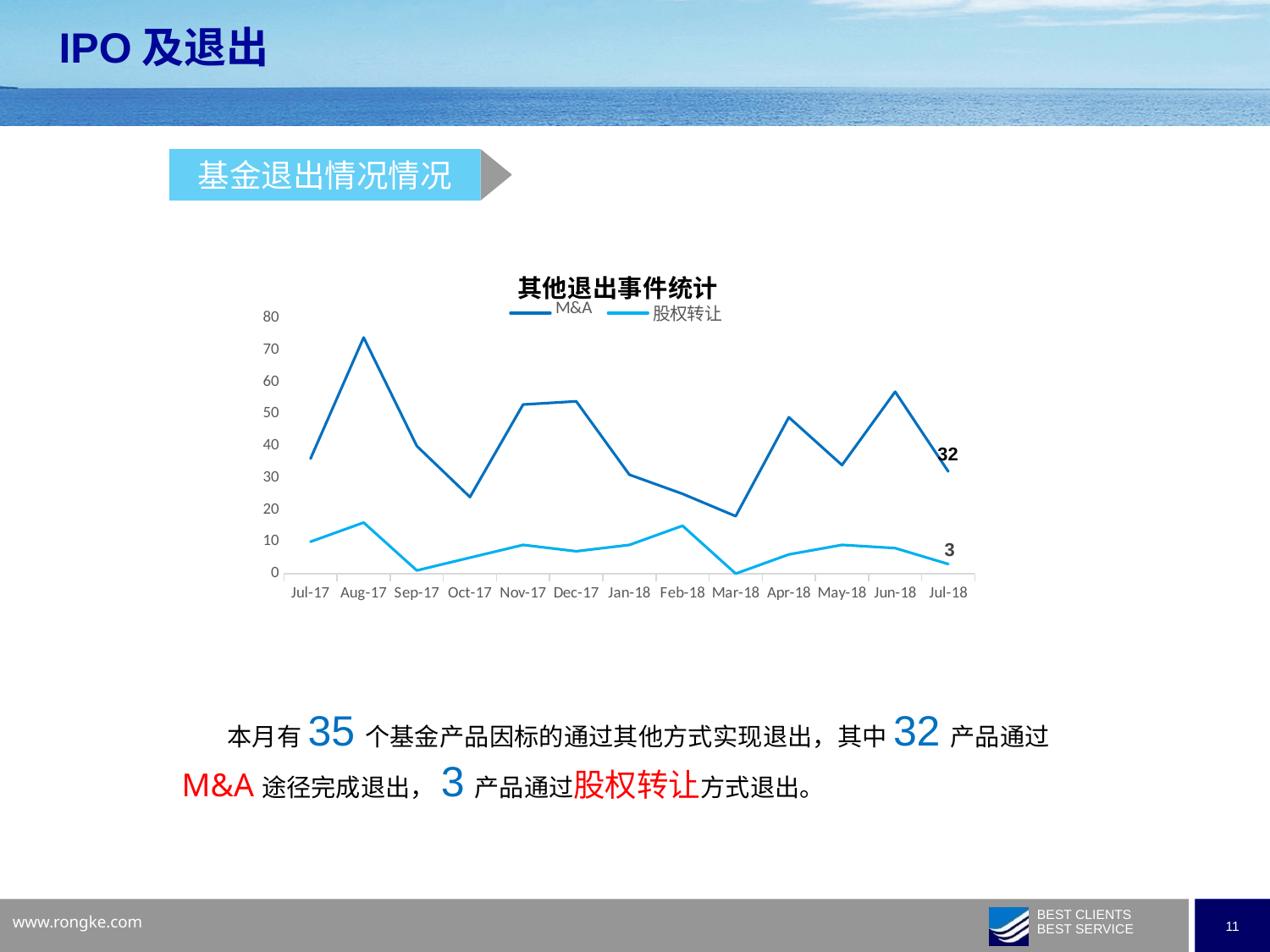
What is the value of the 股权转让 series for Jul-18? 3 Is the 股权转让 value for Aug-17 greater or less than 10? greater What is the difference between the M&A value and the 股权转让 value for Jul-18? 29 Which series has the larger value for Jul-18, M&A or 股权转让? M&A How many months are shown on the x axis of the chart? 13 How many series does the chart's legend list? 2 Which is larger for the M&A series, the value for Aug-17 or the value for Jun-18? Aug-17 In which month does the M&A series reach its lowest value? Mar-18 What is the value of the M&A series for Jul-18? 32 In which month does the M&A series reach its highest value? Aug-17 Is the M&A value for Aug-17 greater or less than 70? greater